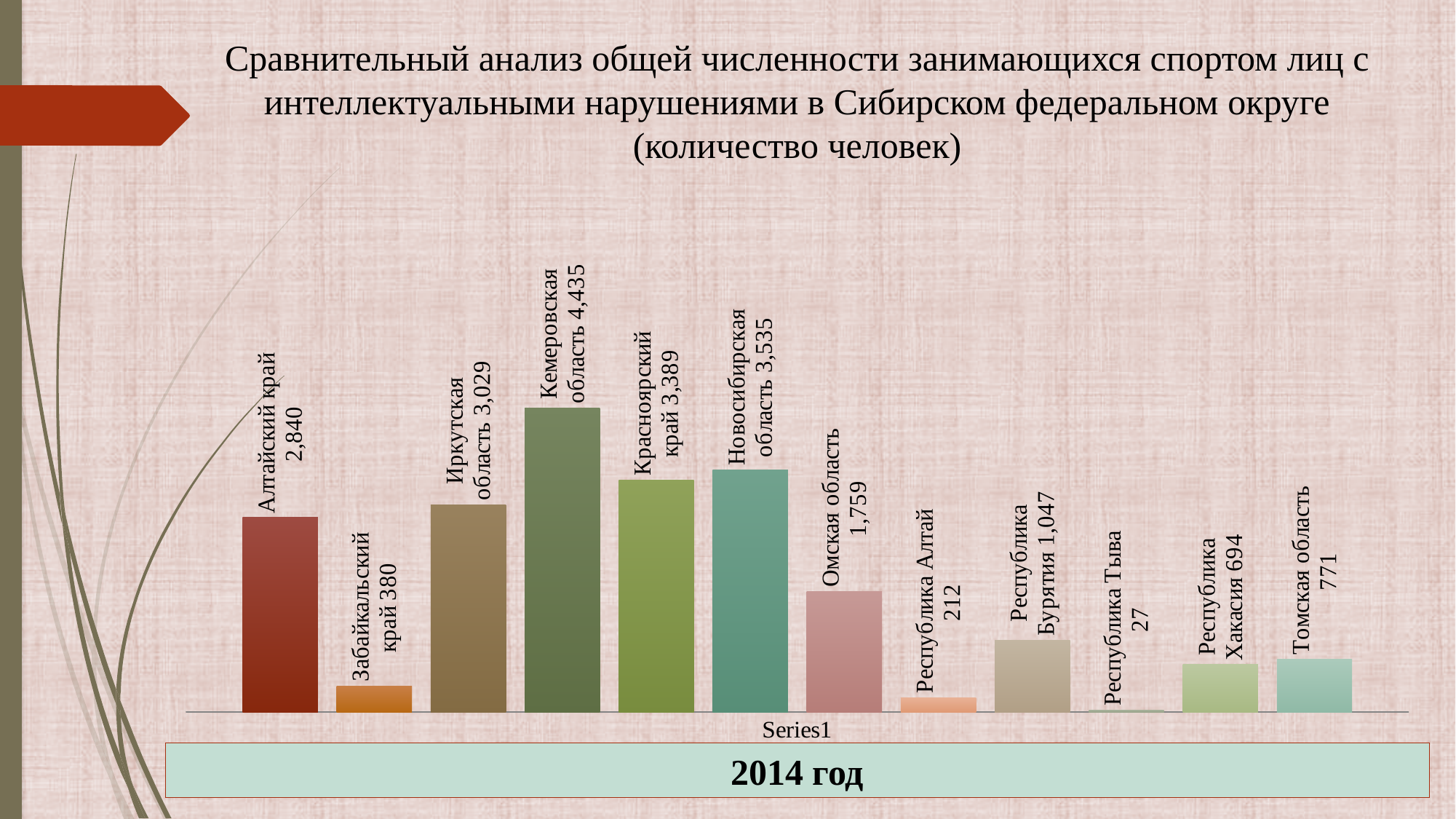
Which is larger, the value for Забайкальский край or the value for Республика Алтай? Забайкальский край Which year is shown in the label below the chart? 2014 год What is the value for Кемеровская область? 4,435 What is the value for Республика Бурятия? 1,047 How many regions are shown in the chart? 12 What is the difference between the values for Томская область and Республика Хакасия? 77 What kind of chart is shown on the slide? Bar chart What is the value for Омская область? 1,759 Which is larger, the value for Алтайский край or the value for Иркутская область? Иркутская область What is the difference between the values for Новосибирская область and Красноярский край? 146 Which region has the lowest value? Республика Тыва Which region has the highest value? Кемеровская область